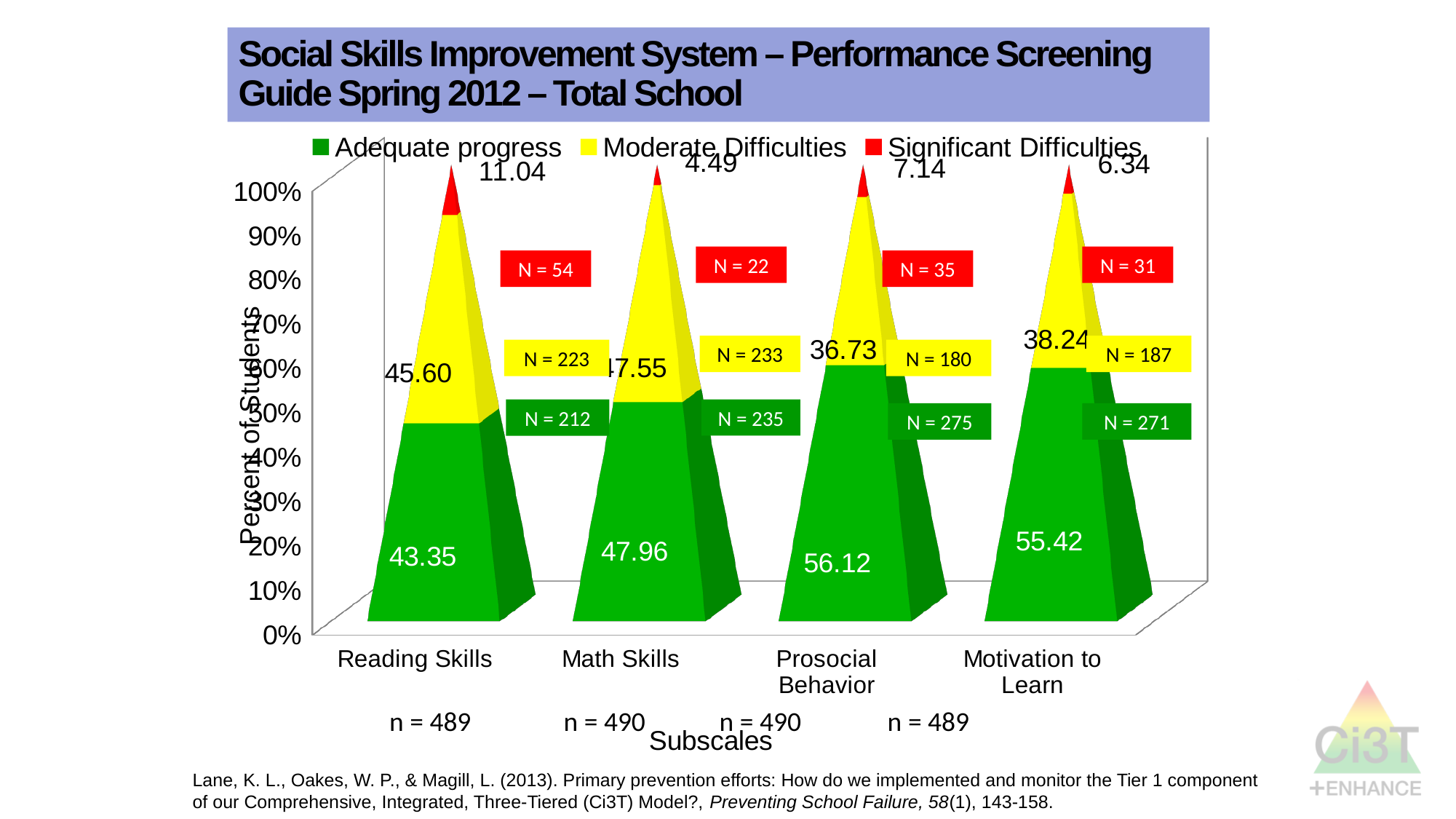
What is the difference between the Adequate progress percentages for Prosocial Behavior and Reading Skills? 12.77 What kind of chart is shown on the slide? Stacked bar chart What percentage of students showed Adequate progress on the Prosocial Behavior subscale? 56.12 What percentage of students had Significant Difficulties on the Reading Skills subscale? 11.04 What percentage of students had Moderate Difficulties on the Motivation to Learn subscale? 38.24 Which subscale has the highest percentage of students with Adequate progress? Prosocial Behavior How many subscales are shown on the x axis? 4 What is the N value shown for Significant Difficulties on the Math Skills subscale? N = 22 How many series does the legend list? 3 What is the label of the y axis? Percent of Students Which is larger: the Significant Difficulties percentage for Prosocial Behavior or for Motivation to Learn? Prosocial Behavior Which subscale has the lowest percentage of students with Significant Difficulties? Math Skills